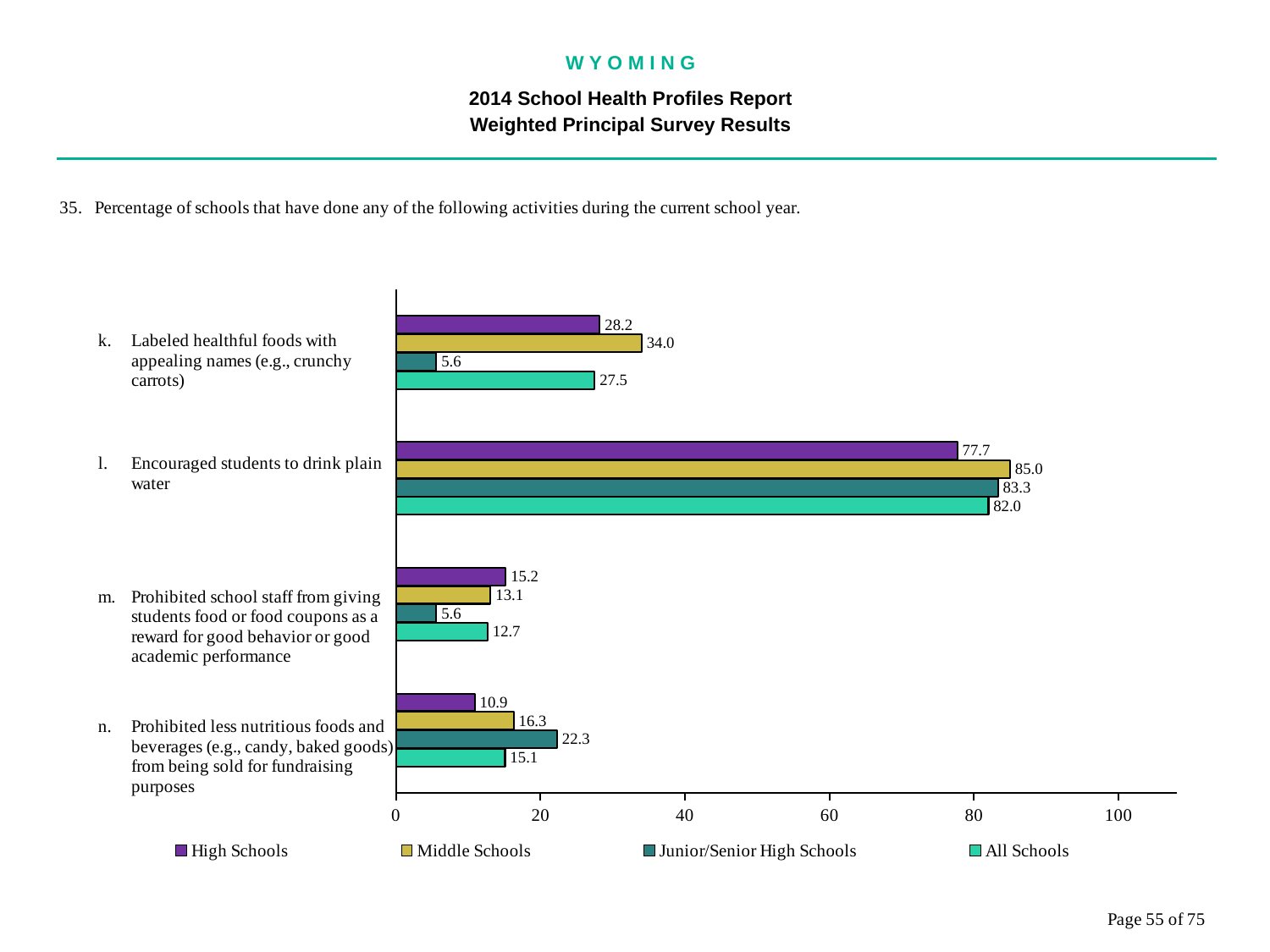
How many activity categories are shown on the chart? 4 What is the difference between the Middle Schools and High Schools values for 'Labeled healthful foods with appealing names'? 5.8 What kind of chart is shown on the slide? Bar chart What is the value for All Schools for 'Prohibited school staff from giving students food or food coupons as a reward'? 12.7 Which series has the lowest value for 'Labeled healthful foods with appealing names'? Junior/Senior High Schools Is the value for All Schools for 'Encouraged students to drink plain water' greater or less than 80? greater What is the value for High Schools for 'Encouraged students to drink plain water'? 77.7 What is the value for Junior/Senior High Schools for 'Prohibited less nutritious foods and beverages from being sold for fundraising purposes'? 22.3 Which series has the highest value for 'Encouraged students to drink plain water'? Middle Schools What is the value for Middle Schools for 'Labeled healthful foods with appealing names'? 34.0 How many series does the legend list? 4 Which is larger for 'Prohibited less nutritious foods and beverages from being sold for fundraising purposes': High Schools or Middle Schools? Middle Schools